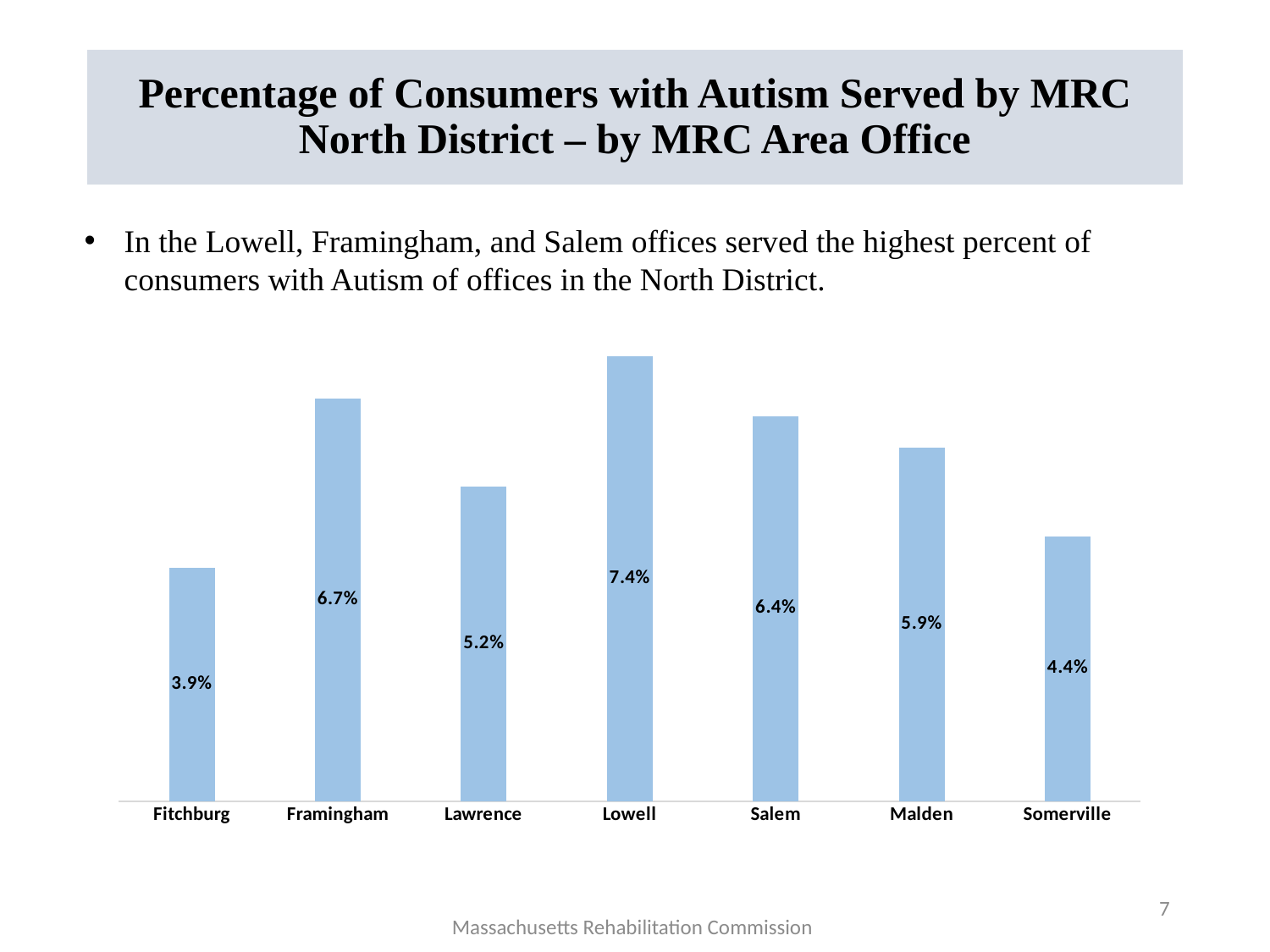
How many offices are shown on the chart? 7 What is the title of the slide? Percentage of Consumers with Autism Served by MRC North District – by MRC Area Office Which is larger, the value for Lawrence or the value for Somerville? Lawrence What is the difference between the values for Lowell and Fitchburg? 3.5% What is the value for Fitchburg? 3.9% Which office has the highest percentage? Lowell What is the value for Lowell? 7.4% Which is larger, the value for Framingham or the value for Malden? Framingham What is the difference between the values for Framingham and Salem? 0.3% What is the value for Malden? 5.9% Which office has the lowest percentage? Fitchburg What kind of chart is shown on the slide? Bar chart